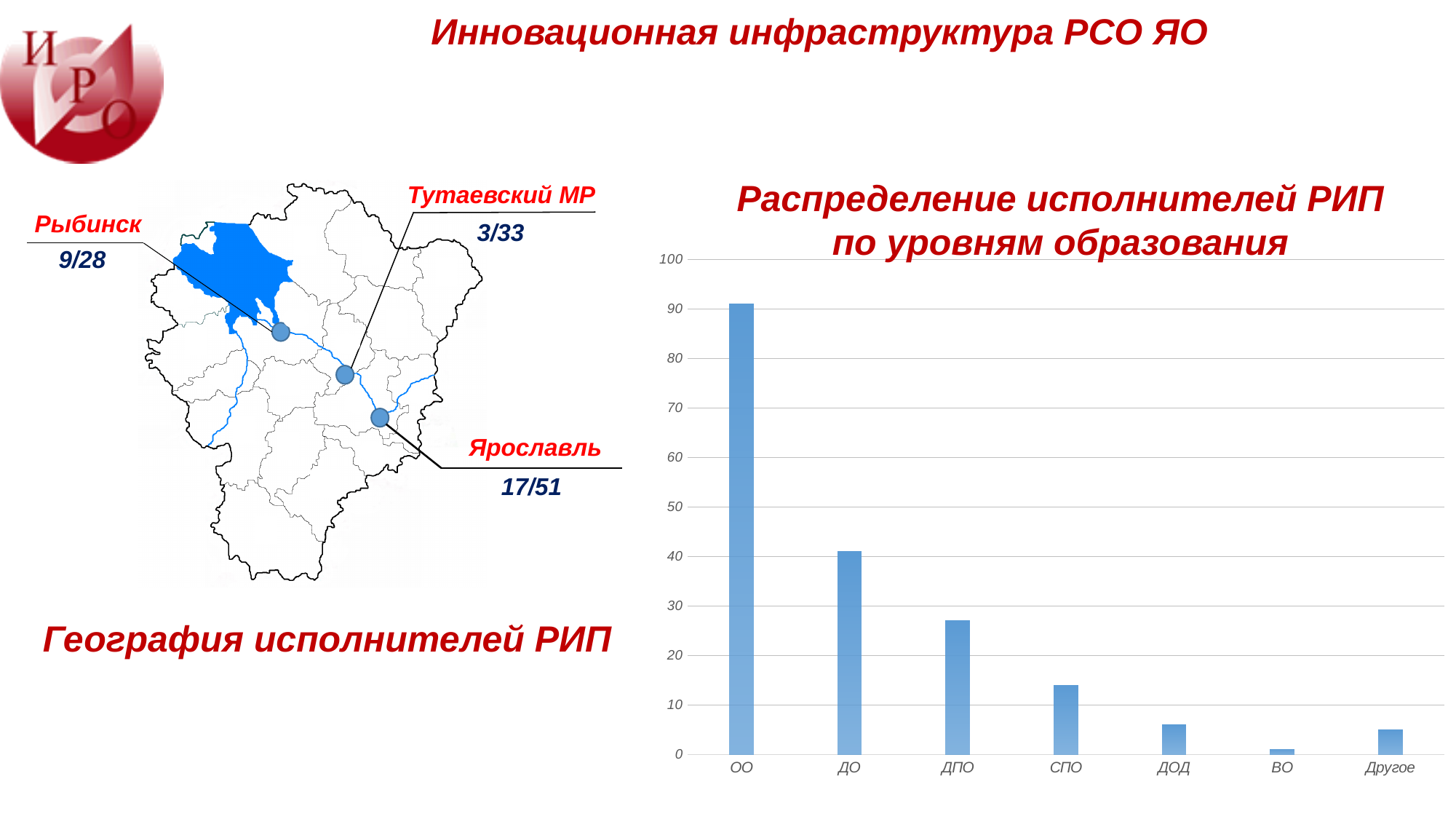
What kind of chart is shown under the title "Распределение исполнителей РИП по уровням образования"? bar chart Which category has the highest bar in the chart? ОО Which category has the lowest bar in the chart? ВО Is the value for ДПО greater or less than 20? greater Is the value for ОО greater or less than 80? greater Is the value for ДОД greater or less than 10? less Which is larger, the value for ДО or the value for ДПО? ДО How many categories are shown on the x axis of the bar chart? 7 What is the title of the bar chart on the right of the slide? Распределение исполнителей РИП по уровням образования Do the bar values rise or fall from ОО to ВО along the x axis? fall